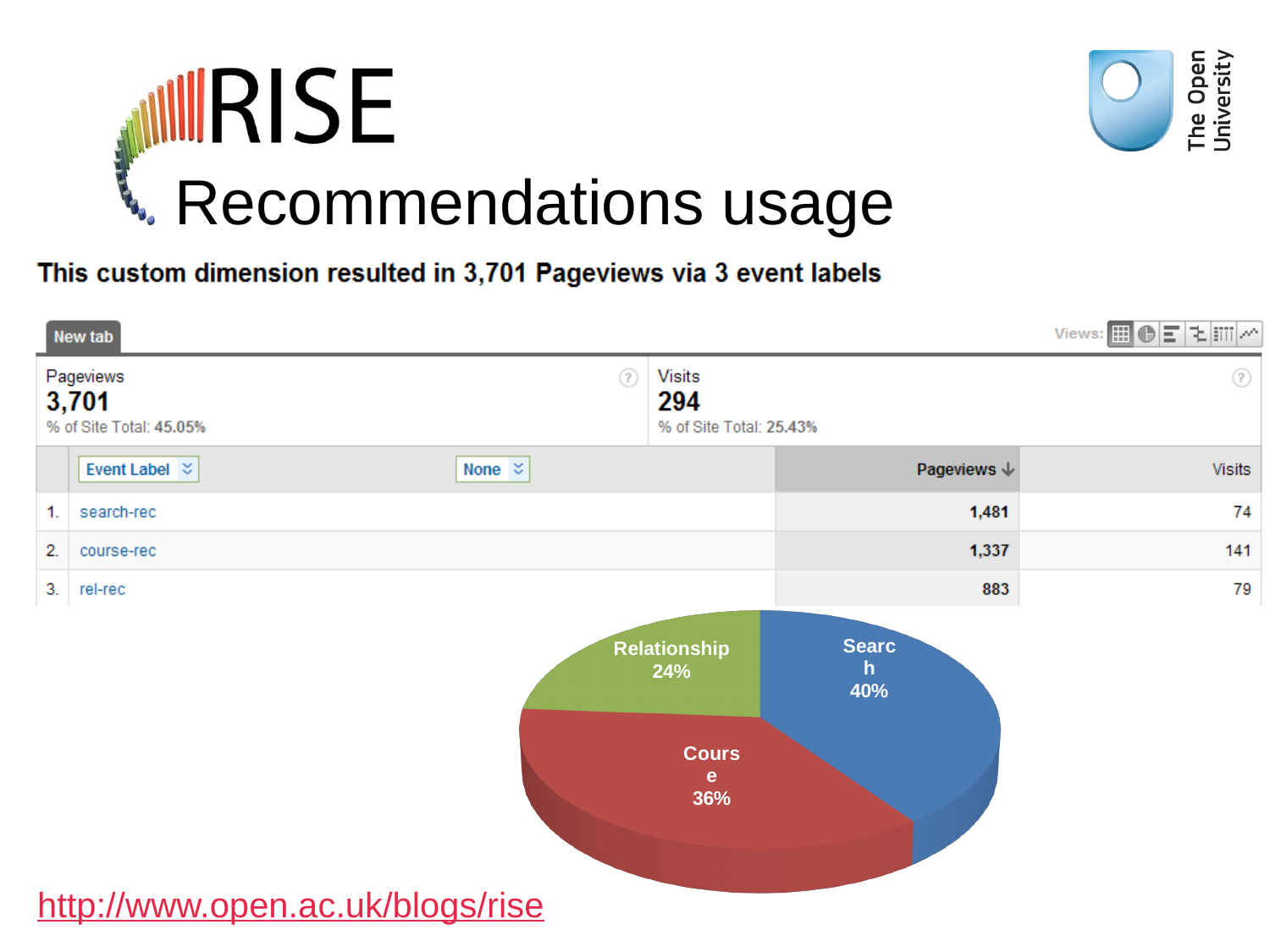
In the pie chart, which is larger, the Course slice or the Relationship slice? Course What share of the pie chart does the Course slice represent? 36% What kind of chart is shown on the slide? pie chart What share of the pie chart does the Search slice represent? 40% What is the difference in percentage points between the Course slice and the Relationship slice in the pie chart? 12 Which slice of the pie chart is the largest? Search What colour is the Relationship slice in the pie chart? green What share of the pie chart does the Relationship slice represent? 24% How many slices does the pie chart have? 3 Which slice of the pie chart is the smallest? Relationship What is the difference in percentage points between the Search slice and the Course slice in the pie chart? 4 What colour is the Search slice in the pie chart? blue